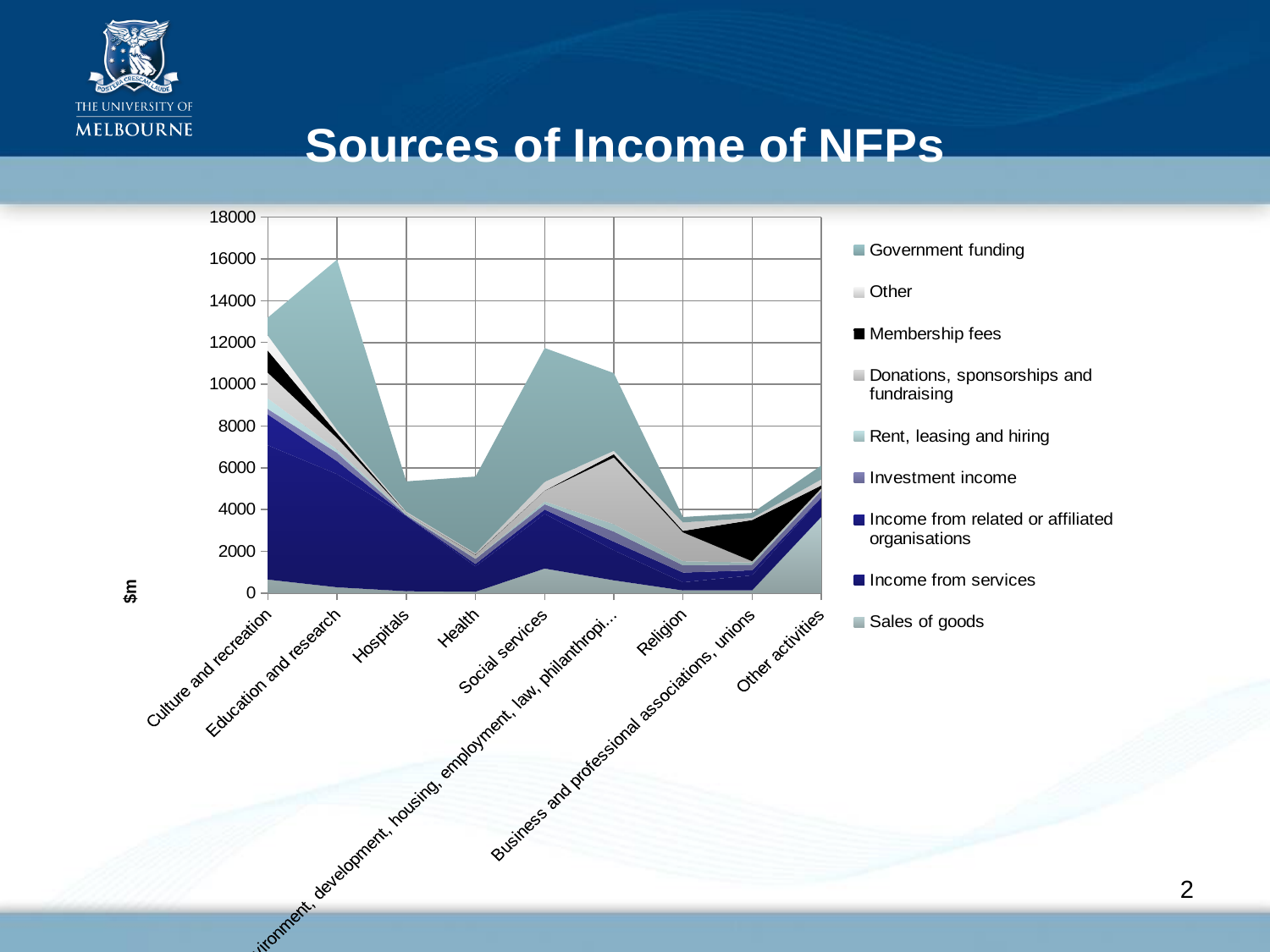
Does the total income rise or fall from Education and research to Hospitals? fall How many series does the legend list? 9 Is the total income for Health greater or less than 8000? less Which has the larger total income, Culture and recreation or Hospitals? Culture and recreation Which category has the highest total income? Education and research Is the total income for Education and research greater or less than 14000? greater What kind of chart is shown on the slide? Stacked area chart What is the label on the y axis? $m What is the title of the chart? Sources of Income of NFPs Is the total income for Social services greater or less than 10000? greater How many categories are shown along the x axis? 9